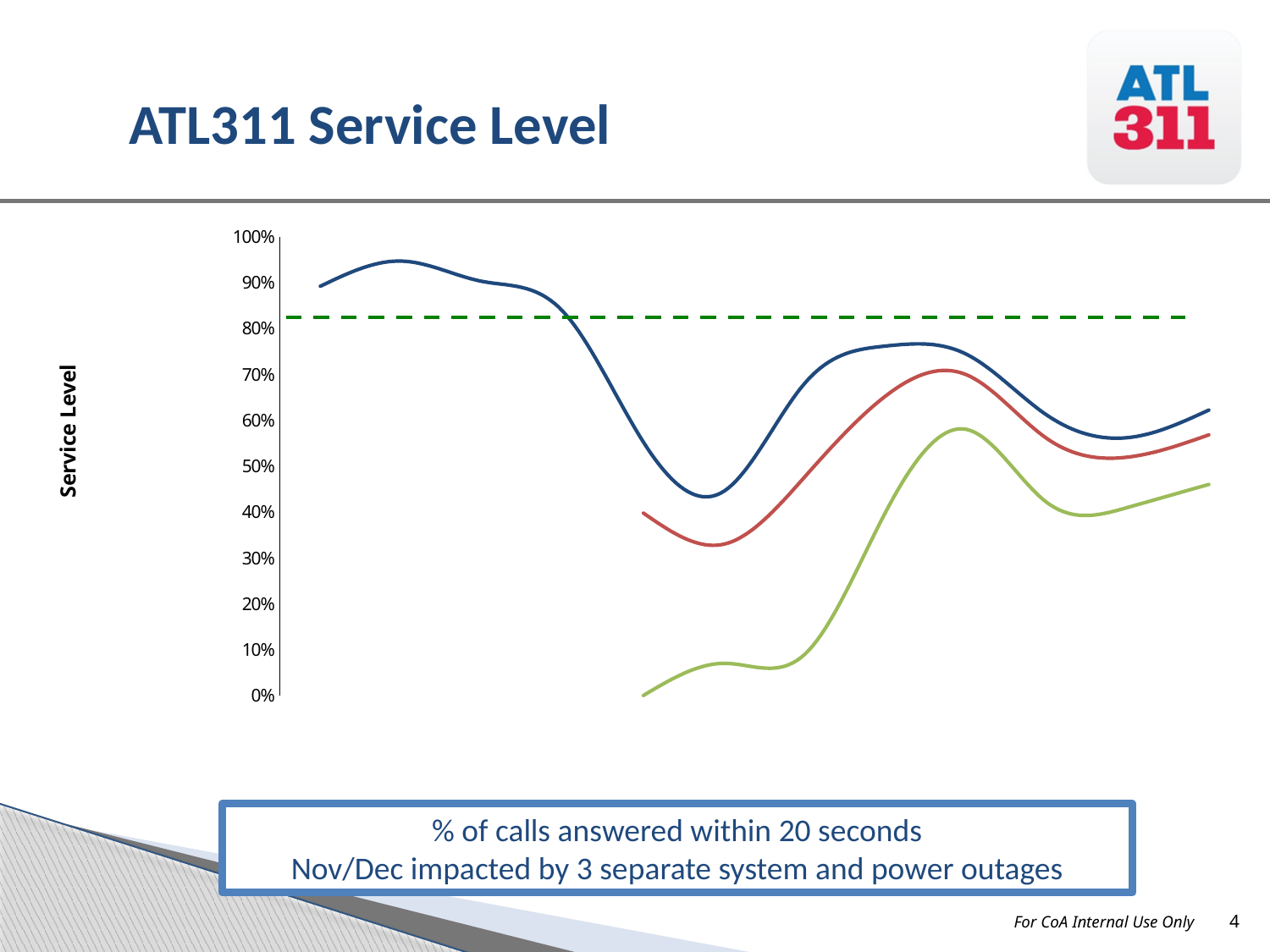
Is the highest point of the red line greater or less than 80%? less Is the lowest point of the dark blue line greater or less than 50%? less What is the highest value shown on the vertical axis of the chart? 100% Which line has the lowest point on the chart, the red line or the light green line? the light green line What is the title of the vertical axis on the chart? Service Level Is the starting point of the light green line greater or less than 10%? less What kind of chart is shown on the slide? line chart Which line reaches the highest point on the chart, the dark blue line or the light green line? the dark blue line